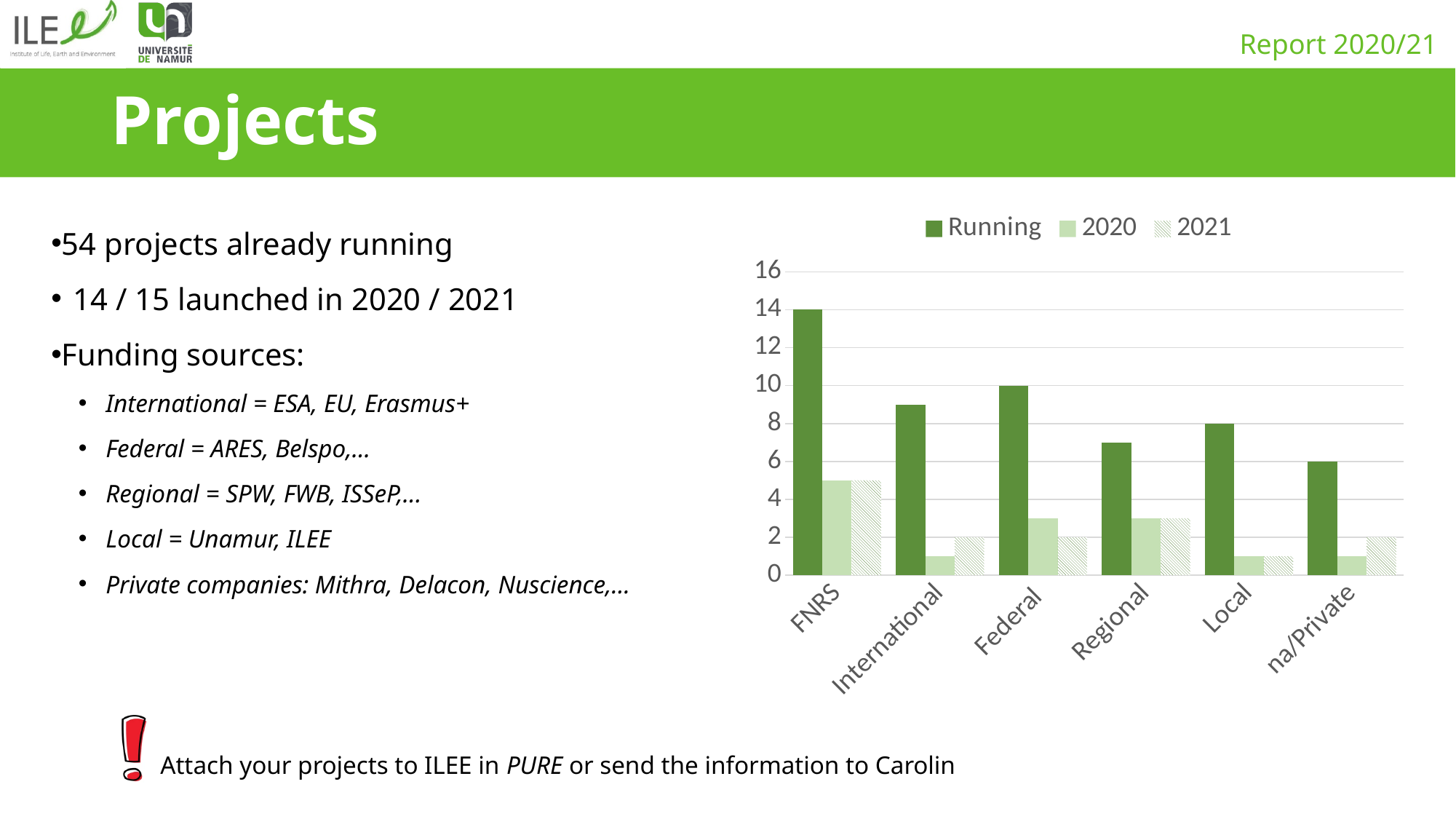
Which category has the highest Running value? FNRS What is the difference between the Running values for Federal and Local? 2 What is the 2021 value for na/Private? 2 How many series does the chart legend list? 3 What is the Running value for FNRS? 14 Which series is shown with a hatched pattern in the chart? 2021 How many funding source categories are shown on the x axis of the chart? 6 What is the Running value for Local? 8 Is the Running value for Regional greater or less than 8? less What is the Running value for Federal? 10 Which category has the lowest Running value? na/Private What type of chart is shown on the slide? bar chart